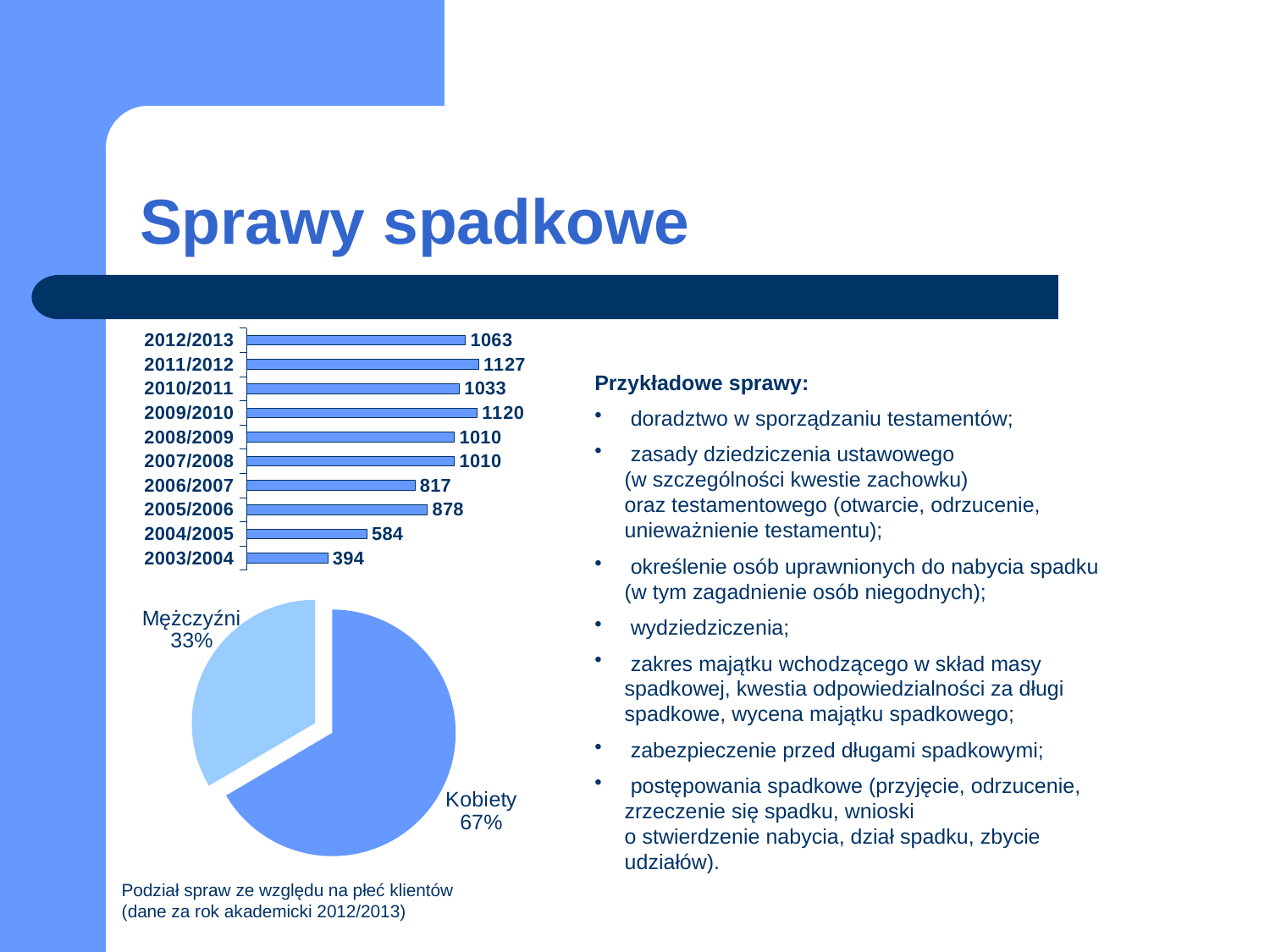
What kind of chart is the chart at the top left of the slide? Bar chart What kind of chart is the chart at the bottom left of the slide? Pie chart In the bar chart at the top left, what is the value for 2003/2004? 394 In the pie chart at the bottom left, what share is Kobiety? 67% In the bar chart at the top left, how many academic years are shown? 10 In the bar chart at the top left, what is the difference between the values for 2011/2012 and 2010/2011? 94 In the bar chart at the top left, which academic year has the highest value? 2011/2012 In the bar chart at the top left, what is the value for 2012/2013? 1063 In the pie chart at the bottom left, what share is Mężczyźni? 33% In the bar chart at the top left, what is the difference between the values for 2004/2005 and 2003/2004? 190 In the bar chart at the top left, which academic year has the lowest value? 2003/2004 In the bar chart at the top left, which is larger, the value for 2005/2006 or the value for 2006/2007? 2005/2006